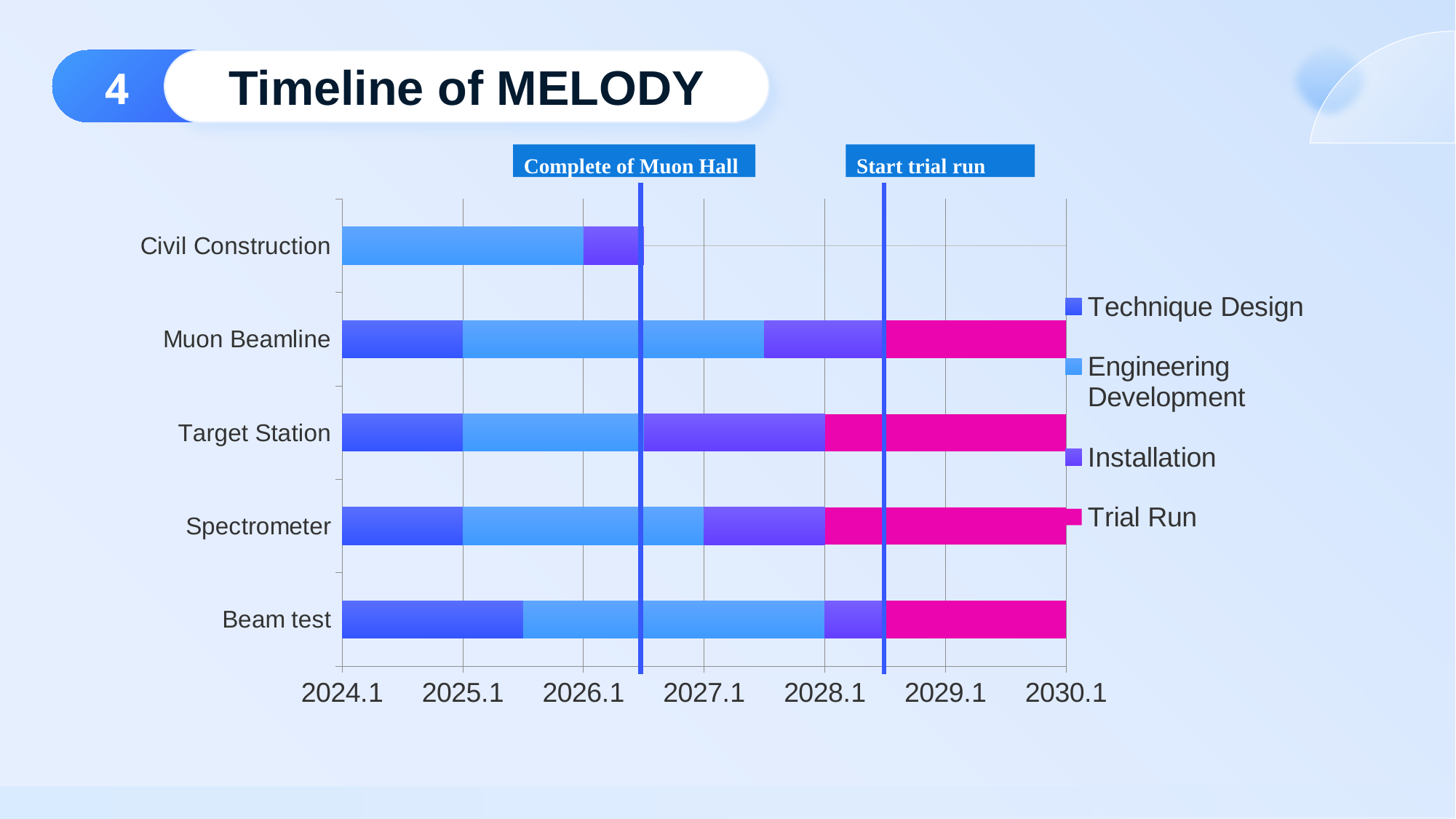
At which axis tick does the Trial Run segment for Target Station begin? 2028.1 What are the two milestone labels marked by vertical lines on the chart? Complete of Muon Hall; Start trial run Which category's bar ends earliest on the time axis? Civil Construction How many series does the legend list? 4 How many categories (rows) are shown on the chart? 5 At which axis tick does the Engineering Development segment for Beam test end? 2028.1 Does the Civil Construction bar end before or after 2027.1? before Which has a longer Technique Design segment, Beam test or Muon Beamline? Beam test What is the title of the slide containing the chart? Timeline of MELODY At which axis tick does the Installation segment for Spectrometer begin? 2027.1 What kind of chart is shown on the slide? Stacked horizontal bar chart (Gantt-style) Which category has no Trial Run segment? Civil Construction